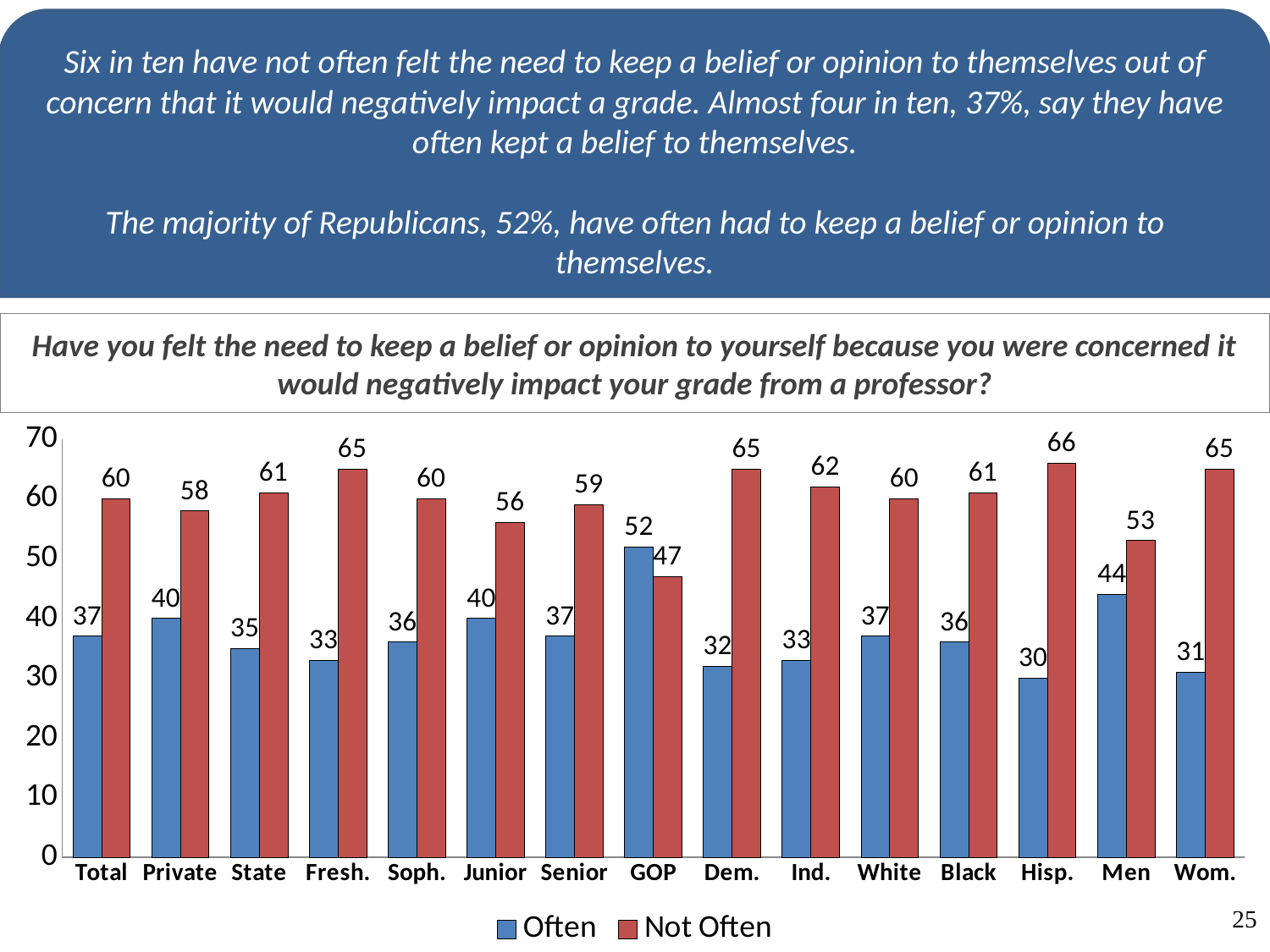
What is the 'Not Often' value for Hisp.? 66 What is the 'Often' value for Wom.? 31 Which category has the highest 'Often' value? GOP What is the 'Often' value for GOP? 52 What is the difference between the 'Not Often' and 'Often' values for Total? 23 How many categories are shown on the x axis? 15 What colour are the 'Not Often' bars? red How many series does the legend list? 2 Is the 'Often' value for Dem. greater or less than 40? less Which category has the lowest 'Not Often' value? GOP Which is larger for Men: the 'Often' value or the 'Not Often' value? Not Often What kind of chart is shown on the slide? bar chart